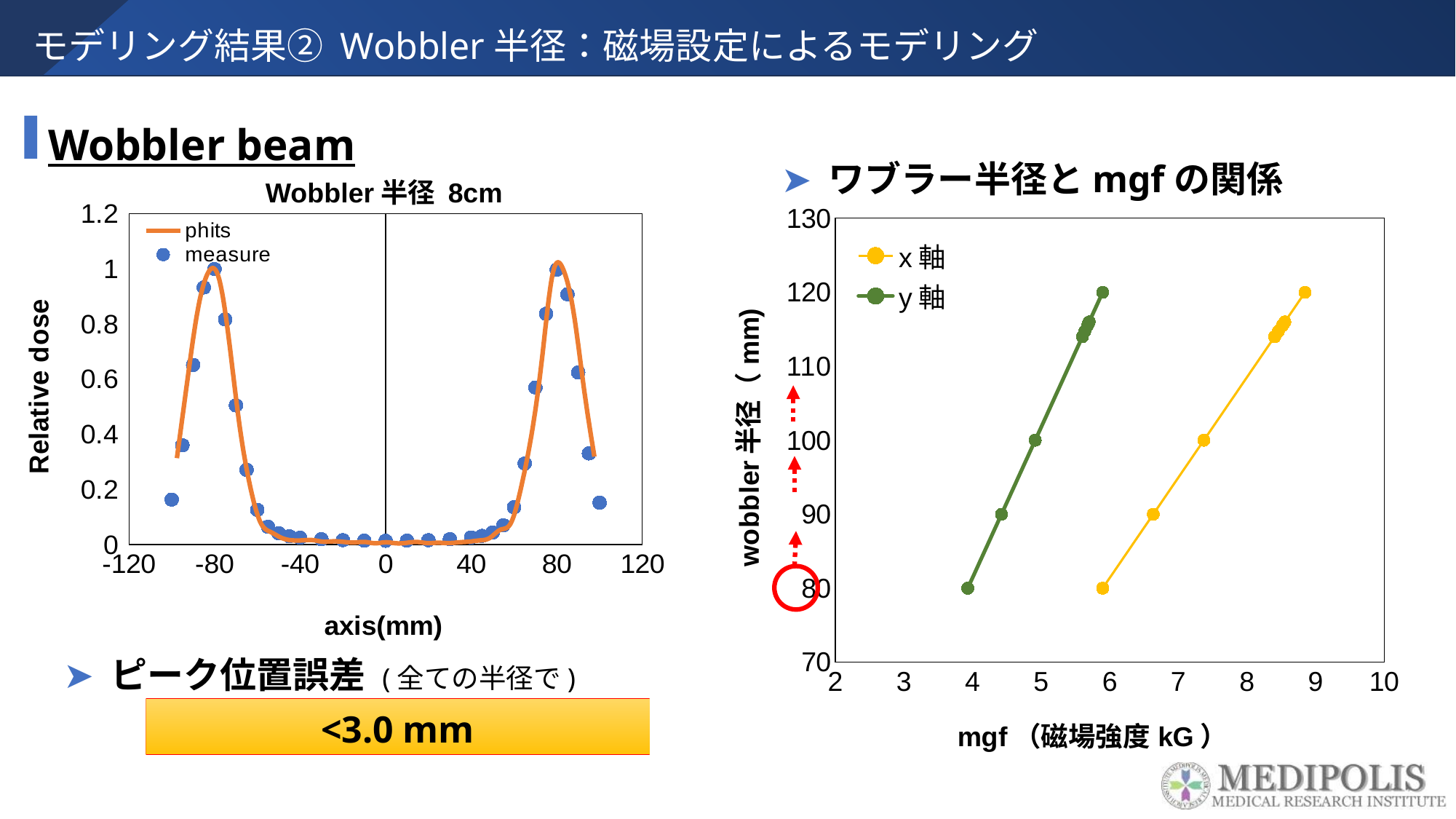
On the right chart (ワブラー半径と mgf の関係), at a wobbler radius of 100 mm, which series has the larger mgf value, x 軸 or y 軸? x 軸 On the right chart (ワブラー半径と mgf の関係), is the mgf value for the x 軸 series at a wobbler radius of 120 mm greater or less than 8? greater On the left chart (Wobbler 半径 8cm), what is the label of the vertical axis? Relative dose On the right chart (ワブラー半径と mgf の関係), what is the lowest wobbler radius plotted for the y 軸 series? 80 On the right chart (ワブラー半径と mgf の関係), how many series does the legend list? 2 On the right chart (ワブラー半径と mgf の関係), what kind of chart is it? Line chart On the left chart (Wobbler 半径 8cm), is the measured relative dose at axis position 0 mm greater or less than 0.2? less On the right chart (ワブラー半径と mgf の関係), is the mgf value for the x 軸 series at a wobbler radius of 80 mm greater or less than 7? less On the right chart (ワブラー半径と mgf の関係), what is the highest wobbler radius plotted for the x 軸 series? 120 On the left chart (Wobbler 半径 8cm), how many series does the legend list? 2 On the right chart (ワブラー半径と mgf の関係), do the wobbler radius values rise or fall as mgf increases? Rise On the right chart (ワブラー半径と mgf の関係), what are the two legend entries? x 軸 and y 軸